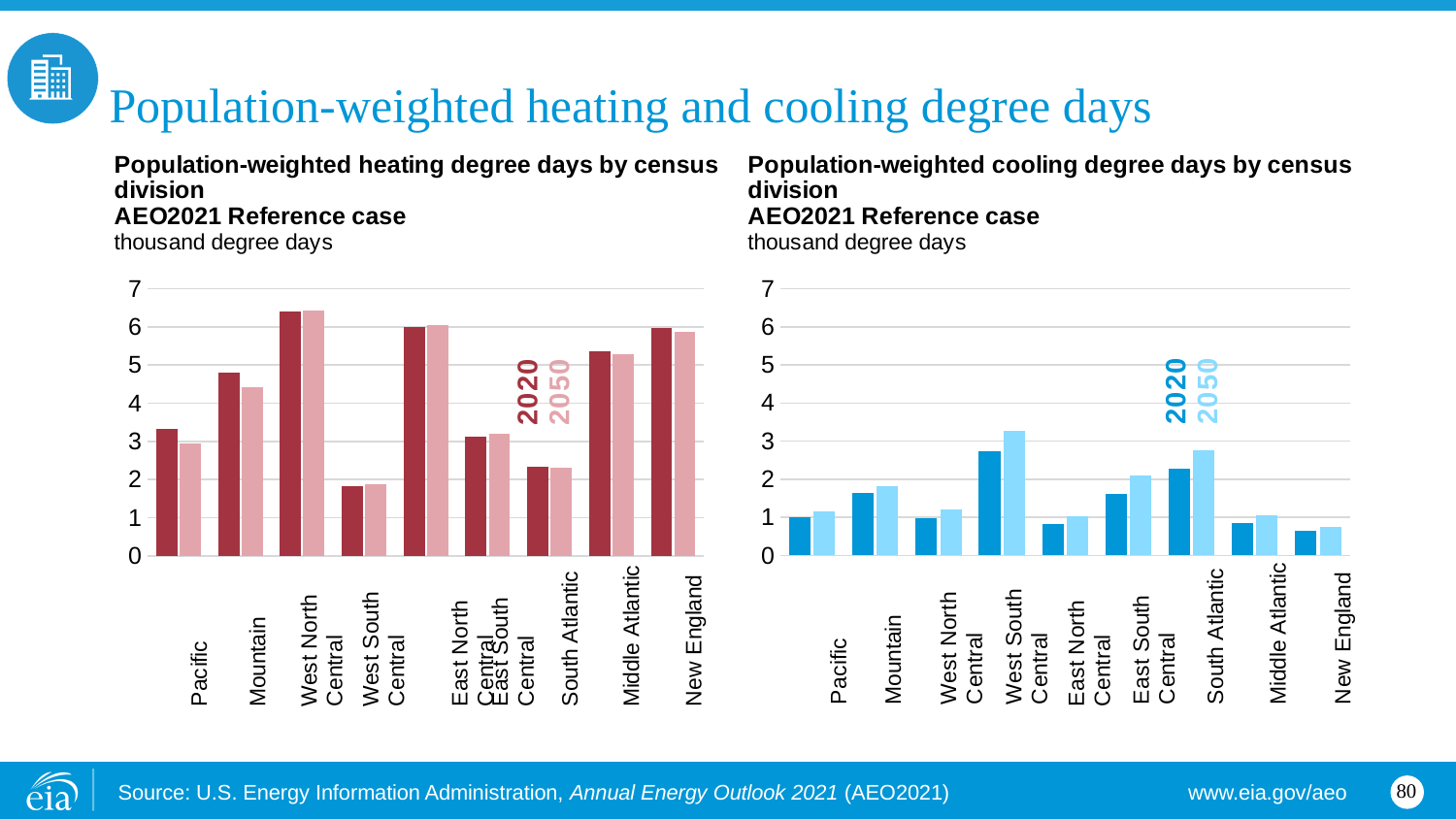
How many census divisions are shown on the 'Population-weighted cooling degree days by census division' chart? 9 On the 'Population-weighted cooling degree days by census division' chart, which census division has the highest 2050 value? West South Central On the 'Population-weighted heating degree days by census division' chart, is the 2020 value for Mountain greater or less than 4? greater On the 'Population-weighted cooling degree days by census division' chart, is the 2050 value for West South Central greater or less than 3? greater On the 'Population-weighted cooling degree days by census division' chart, which census division has the lowest 2020 value? New England How many series does the legend list on the 'Population-weighted heating degree days by census division' chart? 2 On the 'Population-weighted cooling degree days by census division' chart, which is larger for South Atlantic, the 2020 value or the 2050 value? 2050 On the 'Population-weighted heating degree days by census division' chart, which census division has the highest 2020 value? West North Central On the 'Population-weighted heating degree days by census division' chart, which census division has the lowest 2020 value? West South Central On the 'Population-weighted heating degree days by census division' chart, which is larger for Pacific, the 2020 value or the 2050 value? 2020 What kind of chart is the 'Population-weighted heating degree days by census division' chart? bar chart On the 'Population-weighted cooling degree days by census division' chart, is the 2020 value for East North Central greater or less than 1? less